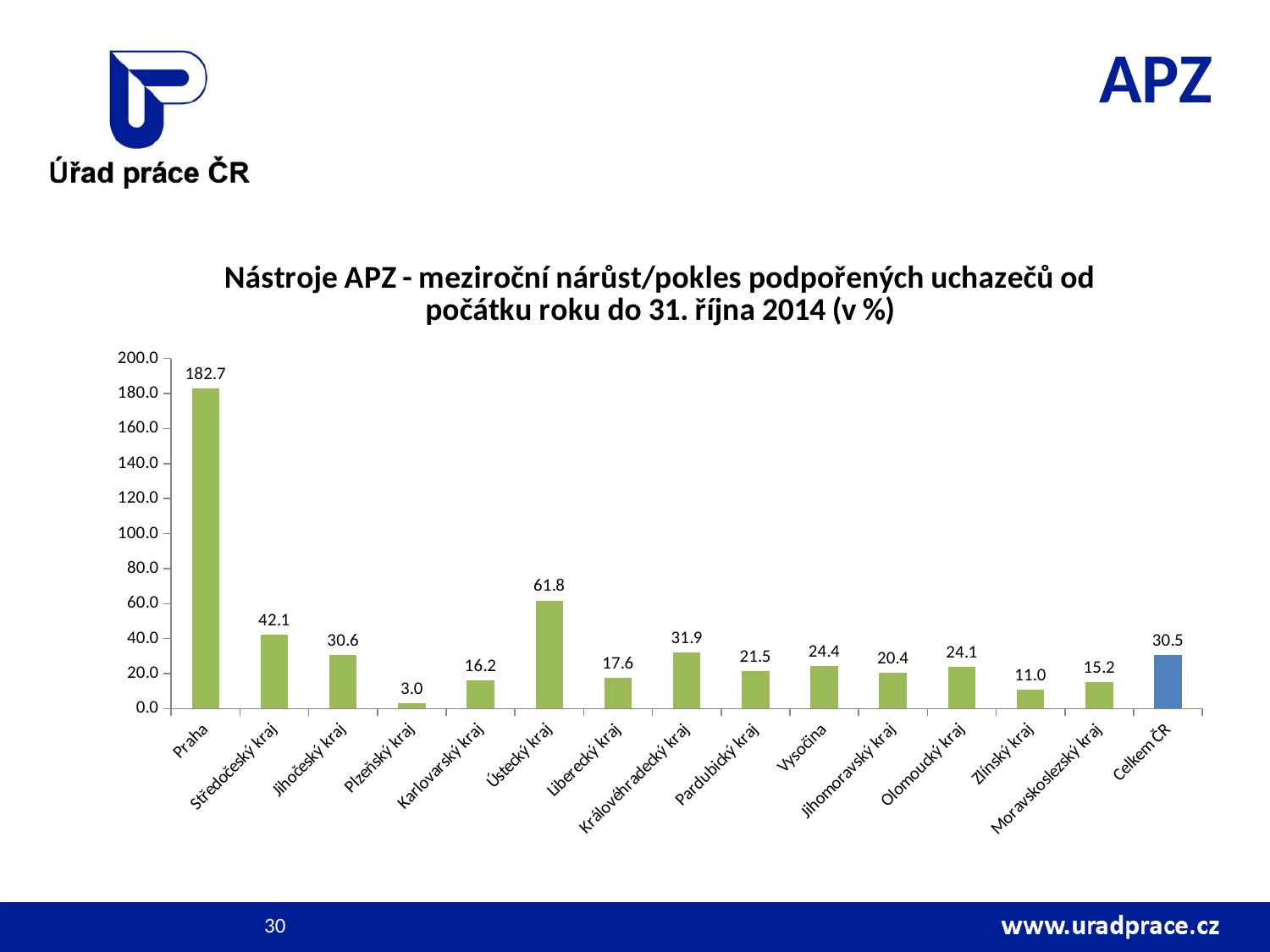
Which category has the lowest value? Plzeňský kraj Which category has the highest value? Praha What is the value for Zlínský kraj? 11.0 What is the difference between the values for Středočeský kraj and Jihočeský kraj? 11.5 What is the title of the chart? Nástroje APZ - meziroční nárůst/pokles podpořených uchazečů od počátku roku do 31. října 2014 (v %) Is the value for Ústecký kraj greater or less than 60.0? greater Which is larger, the value for Vysočina or the value for Olomoucký kraj? Vysočina What is the value for Celkem ČR? 30.5 What is the value for Ústecký kraj? 61.8 What is the value for Praha? 182.7 How many categories are shown on the x axis? 15 What kind of chart is this? bar chart